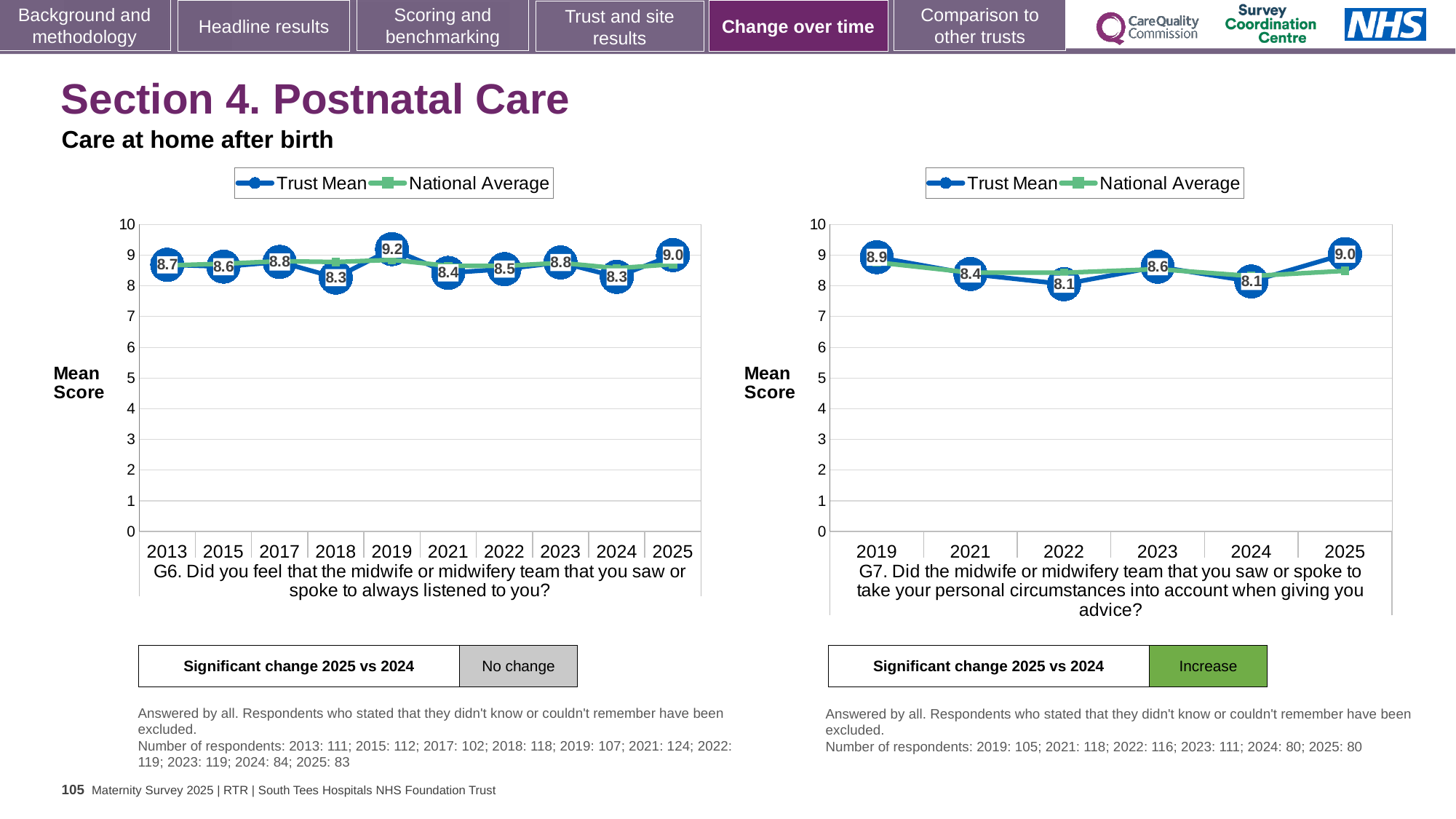
What kind of chart is the left chart (G6)? Line chart In the right chart (G7), what is the Trust Mean for 2022? 8.1 In the right chart (G7), how many series does the legend list? 2 In the left chart (G6), what is the Trust Mean for 2019? 9.2 In the left chart (G6), what is the difference between the Trust Mean for 2019 and the Trust Mean for 2024? 0.9 In the right chart (G7), is the Trust Mean for 2019 or for 2021 larger? 2019 In the left chart (G6), what is the Trust Mean for 2025? 9.0 In the right chart (G7), is the National Average for 2022 greater or less than 7? greater In the left chart (G6), which year has the highest Trust Mean? 2019 In the right chart (G7), what is the difference between the Trust Mean for 2025 and the Trust Mean for 2024? 0.9 In the right chart (G7), which year has the highest Trust Mean? 2025 In the left chart (G6), how many years are plotted on the x axis? 10